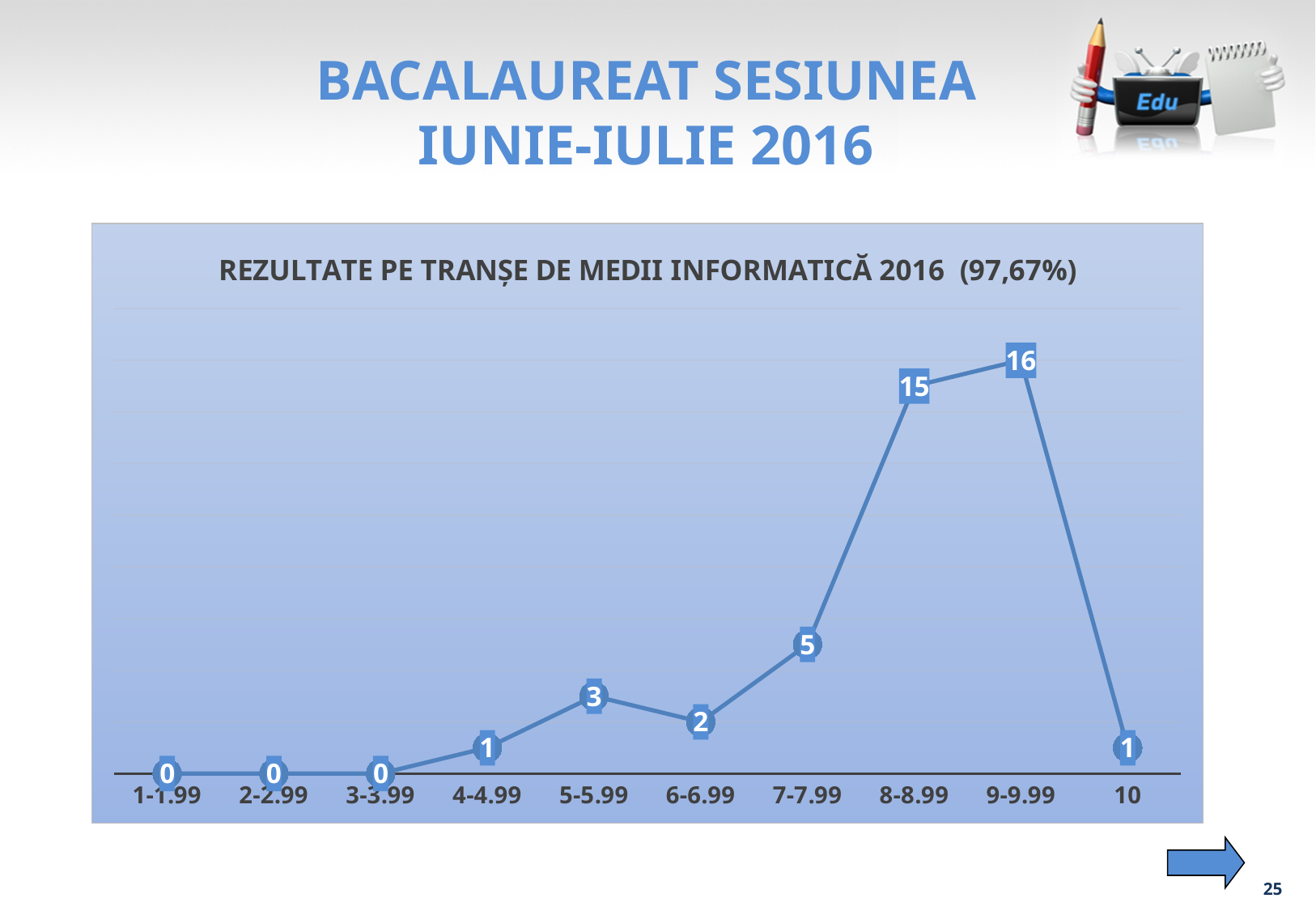
How many categories have a value of 0? 3 What is the value for the 5-5.99 category? 3 What is the value for the 10 category? 1 What is the difference between the values for 8-8.99 and 6-6.99? 13 How many categories are shown on the x axis? 10 What is the value for the 8-8.99 category? 15 Which is larger, the value for 6-6.99 or the value for 7-7.99? 7-7.99 What kind of chart is this? line chart Do the values rise or fall from 7-7.99 to 8-8.99? rise What is the title of the chart? REZULTATE PE TRANȘE DE MEDII INFORMATICĂ 2016 (97,67%) What is the difference between the values for 9-9.99 and 7-7.99? 11 Which category has the highest value? 9-9.99